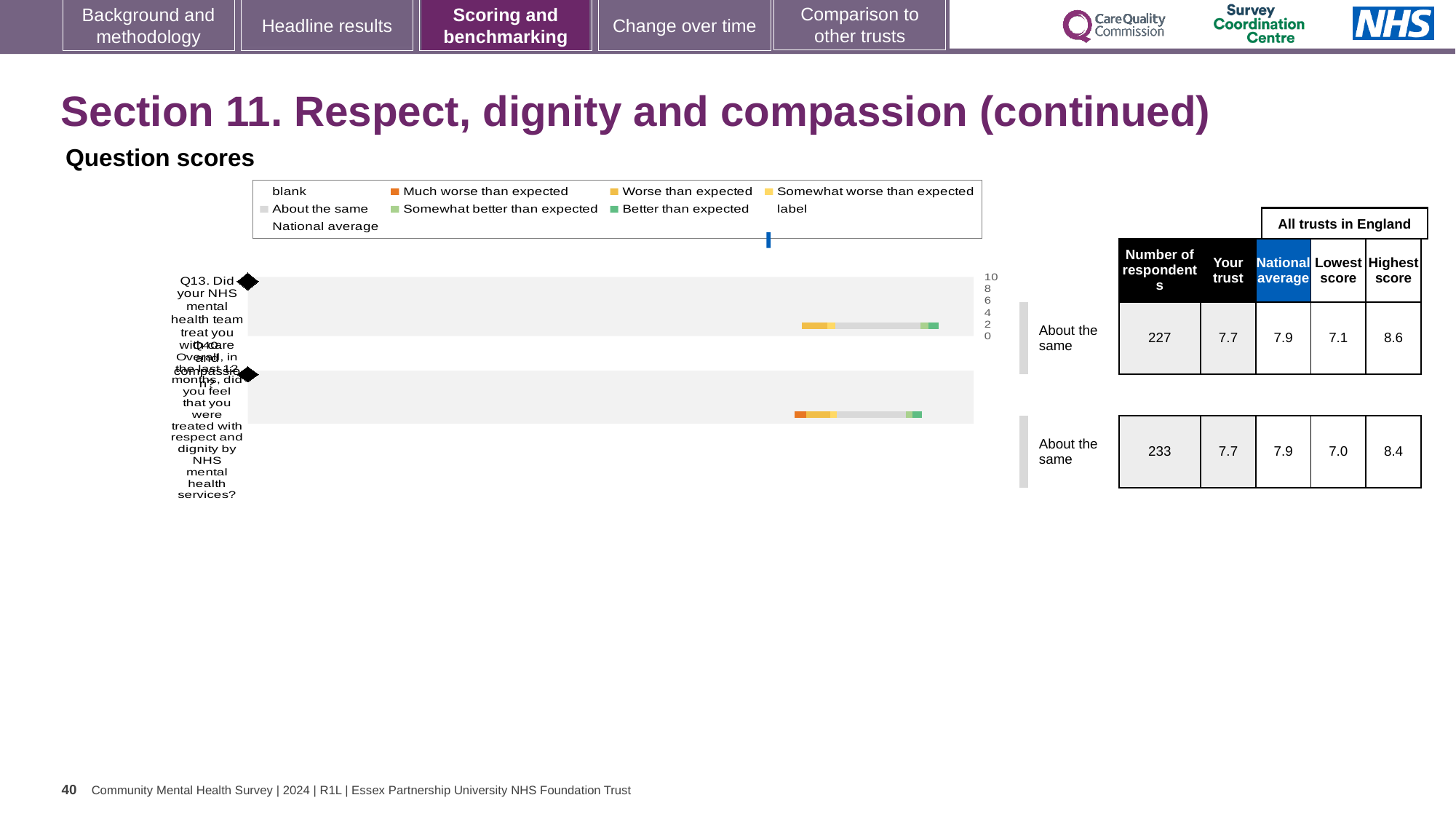
What is the highest score among all trusts in England for Q13? 8.6 What is the national average score for Q14 (treated with respect and dignity)? 7.9 What is the difference between the highest and lowest trust scores for Q13? 1.5 Which colour does the legend use for 'Much worse than expected'? orange How many questions (categories) are plotted in the question scores chart? 2 What is the difference between the highest and lowest trust scores for Q14? 1.4 Which question had more respondents, Q13 or Q14? Q14 What is the lowest score among all trusts in England for Q14? 7.0 What kind of chart is used to show the question scores on this slide? bar chart How many respondents answered Q14? 233 What is the 'Your trust' score for Q13 (treated with care and compassion)? 7.7 What benchmark category is shown for Q13 next to the chart? About the same